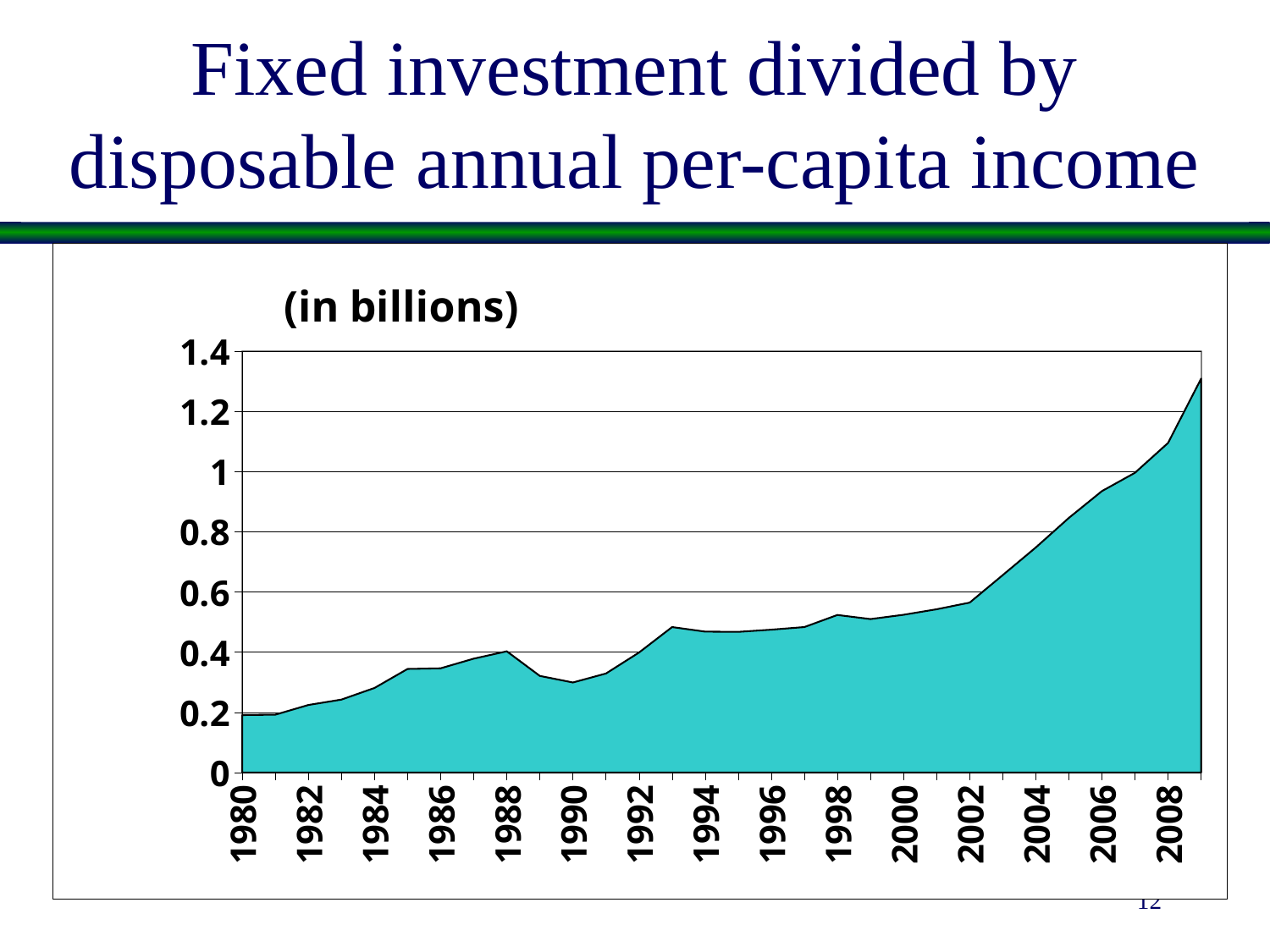
Is the value for 2006 greater or less than 1? less What is the title printed above the chart's plot area? (in billions) Which year has the larger value, 1988 or 1990? 1988 Is the value for 1990 greater or less than 0.4? less What kind of chart is shown on the slide? area chart Is the value for 1984 greater or less than 0.4? less Which year has the larger value, 1996 or 2002? 2002 Of the years labelled on the x axis, which has the highest value? 2008 Do the values generally rise or fall from 1980 to the end of the series? rise